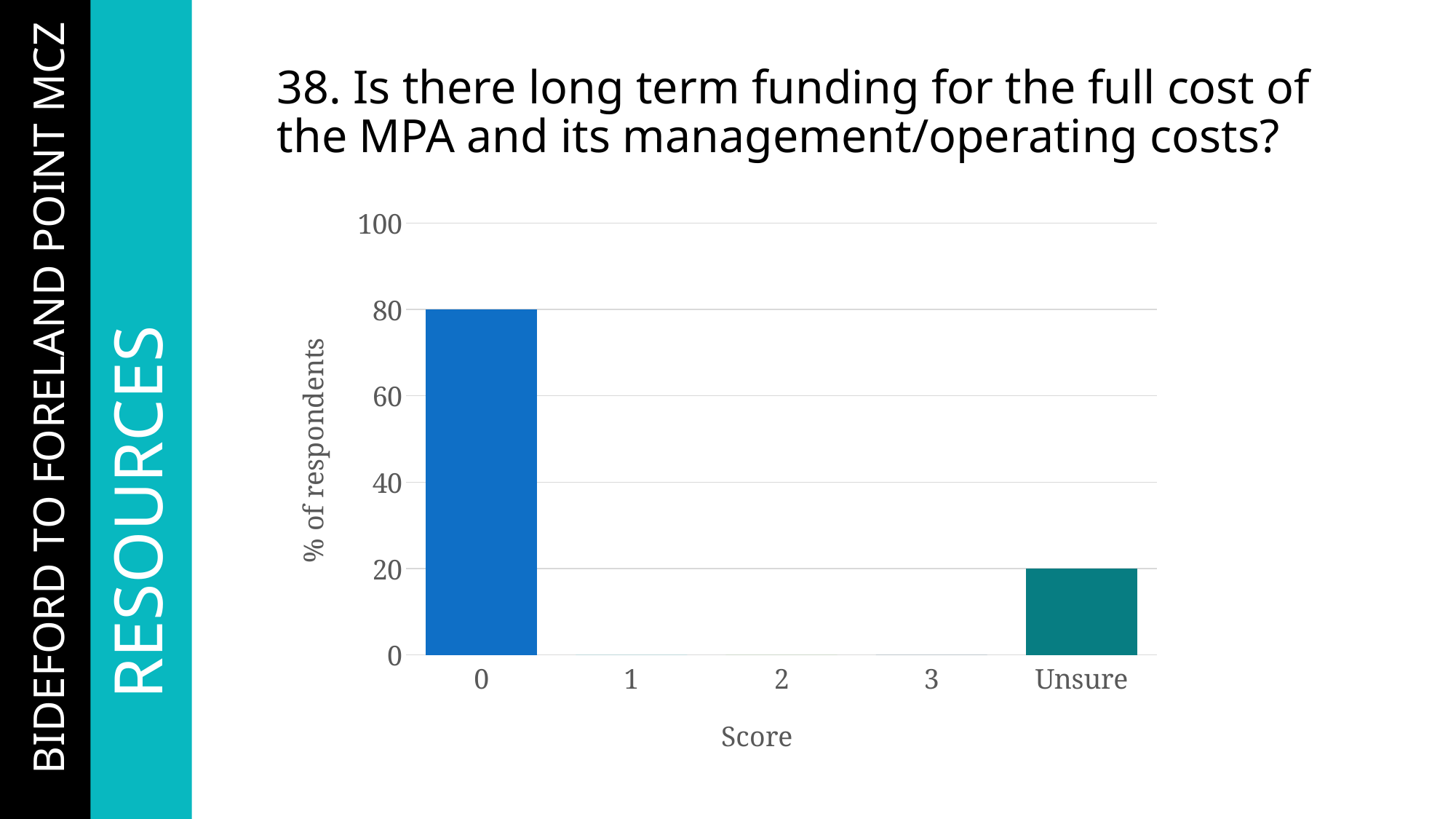
Is the value for Unsure greater or less than 40? less What is the difference between the percentage for score 0 and the percentage for Unsure? 60 Which is larger, the value for score 0 or the value for Unsure? score 0 How many categories are shown on the x axis? 5 What is the label of the x axis? Score What percentage of respondents answered Unsure? 20 What is the label of the y axis? % of respondents What type of chart is shown on the slide? bar chart Which score categories have no visible bar? 1, 2 and 3 What percentage of respondents gave a score of 0? 80 Which score category has the highest percentage of respondents? 0 Is the value for score 0 greater or less than 60? greater